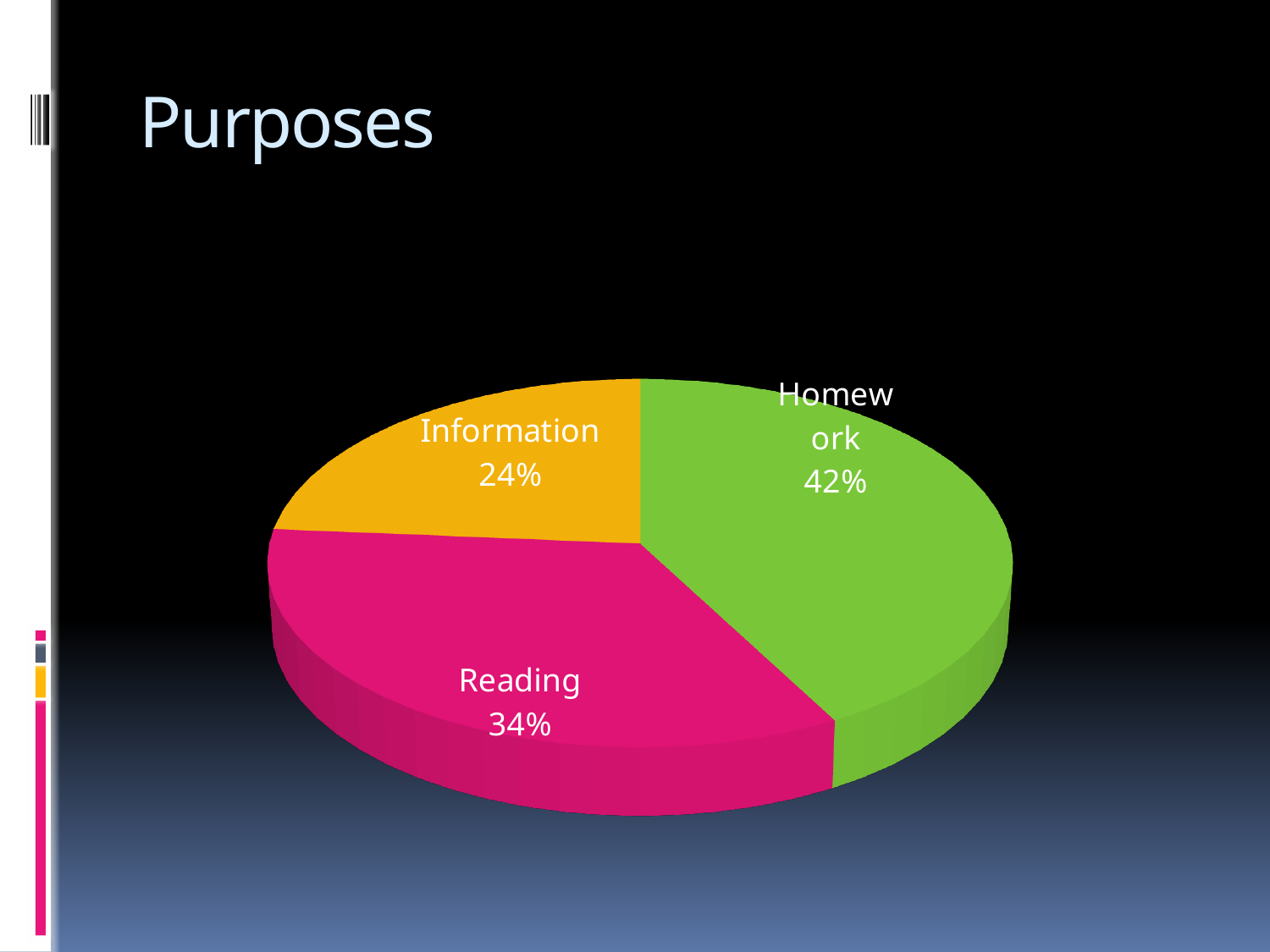
What is the title of the slide containing the pie chart? Purposes What share of the pie does Reading take? 34% Which slice of the pie is the smallest? Information What kind of chart is shown on the slide? pie chart Which is larger, the Reading slice or the Information slice? Reading What colour is the Reading slice of the pie? pink What is the difference in percentage points between Reading and Information? 10 What share of the pie does Homework take? 42% Which slice of the pie is the largest? Homework What share of the pie does Information take? 24% How many slices does the pie chart have? 3 What is the difference in percentage points between Homework and Reading? 8